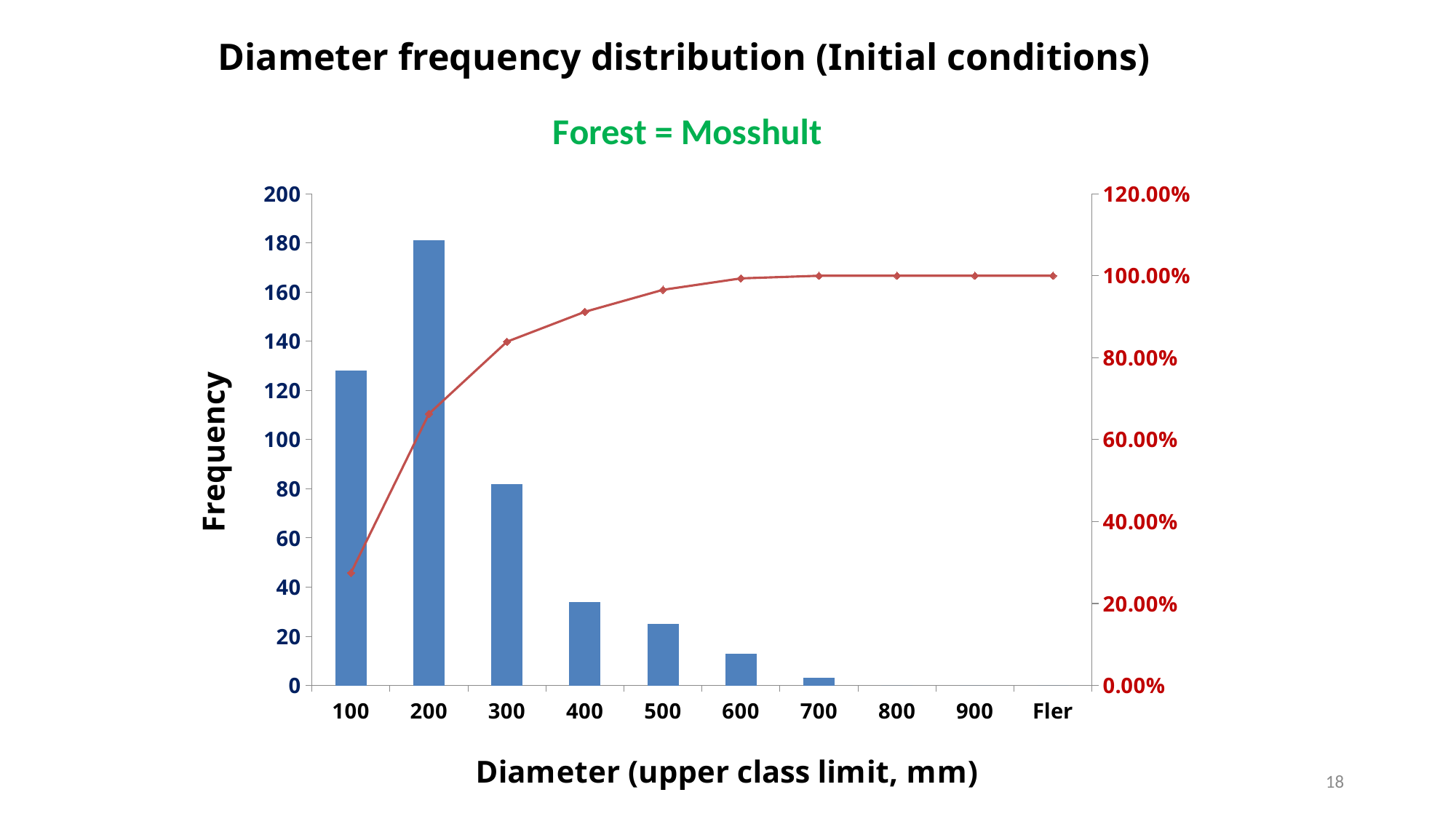
Is the frequency for the 100 diameter class greater or less than 120? greater Which has the higher frequency, the 100 class or the 300 class? 100 What kind of chart is shown on the slide? bar chart with a line Do the frequency bars rise or fall from the 200 class to the 700 class? fall Is the frequency for the 300 diameter class greater or less than 100? less What is the label of the x axis? Diameter (upper class limit, mm) Is the frequency for the 400 diameter class greater or less than 40? less How many categories are shown on the x axis? 10 Which has the higher frequency, the 400 class or the 500 class? 400 What is the highest tick value shown on the right-hand axis? 120.00% Which diameter class has the highest frequency bar? 200